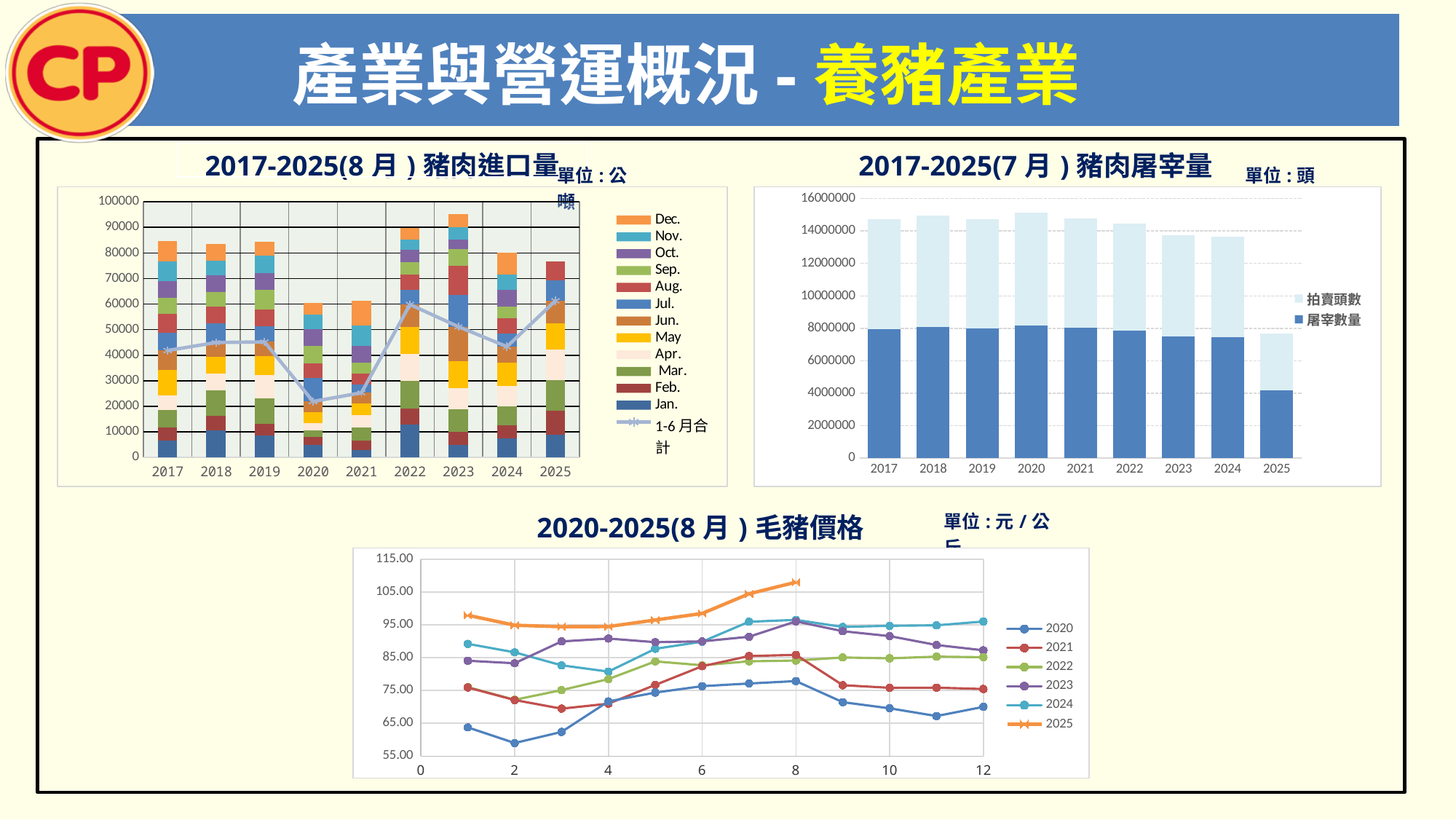
In the 2020-2025(8月) 毛豬價格 chart, does the 2025 line rise or fall from month 4 to month 8? rise How many years are shown on the x axis of the 2017-2025(8月) 豬肉進口量 chart? 9 In the 2017-2025(7月) 豬肉屠宰量 chart, which year has the lowest total? 2025 In the 2017-2025(7月) 豬肉屠宰量 chart, is the 屠宰數量 value for 2025 greater or less than 6000000? less What kind of chart is the 2017-2025(8月) 豬肉進口量 chart? stacked bar chart with a line In the 2020-2025(8月) 毛豬價格 chart, which year's line is highest at month 8? 2025 In the 2017-2025(8月) 豬肉進口量 chart, is the 1-6月合計 line value for 2020 greater or less than 30000? less In the 2017-2025(8月) 豬肉進口量 chart, is the total for 2023 greater or less than 90000? greater What kind of chart is the 2020-2025(8月) 毛豬價格 chart? line chart In the 2017-2025(8月) 豬肉進口量 chart, which year has the tallest stacked bar? 2023 How many series does the legend of the 2017-2025(7月) 豬肉屠宰量 chart list? 2